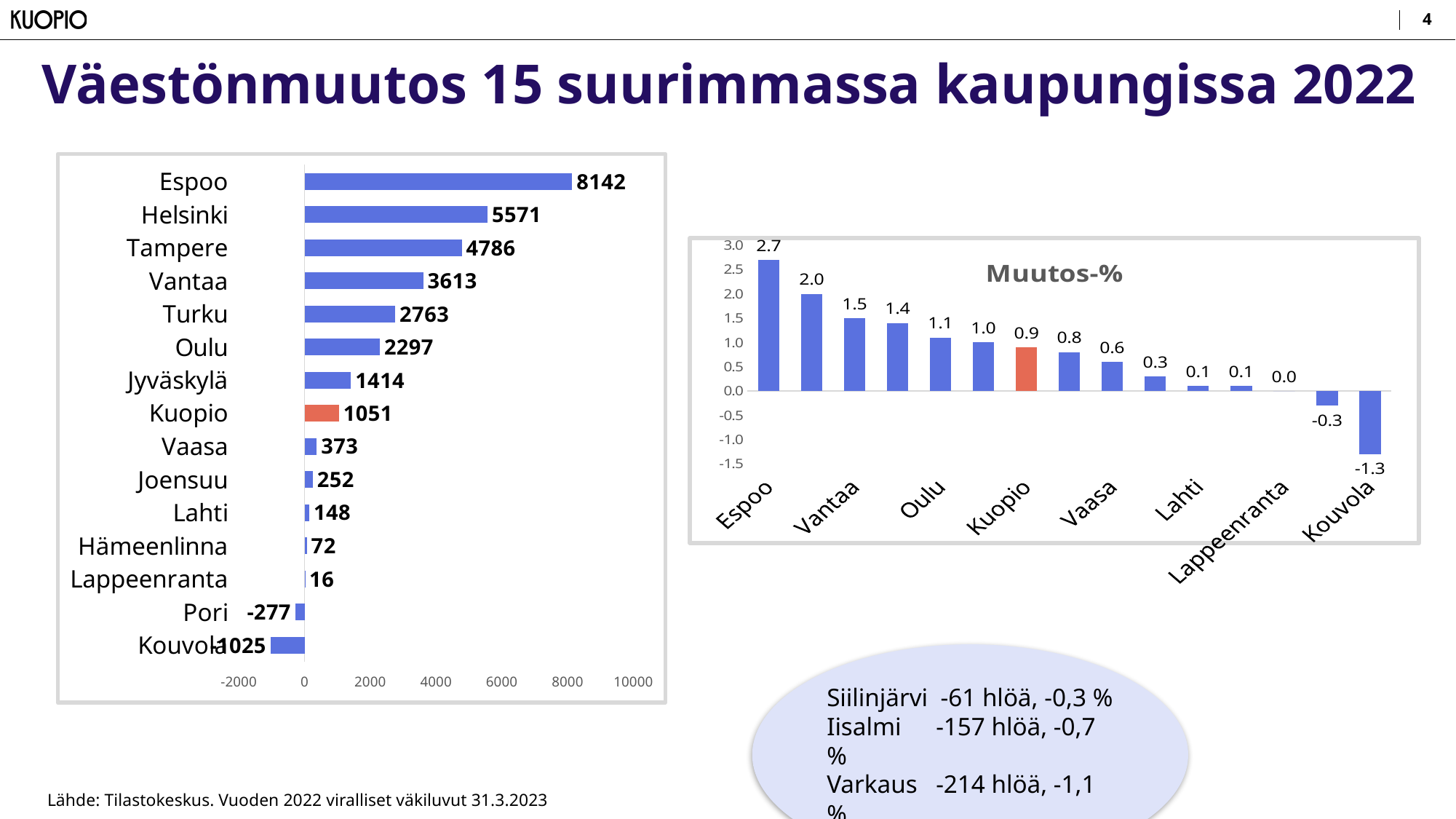
In the left bar chart, what is the value for Kuopio? 1051 In the Muutos-% chart, which city has the highest value? Espoo In the left bar chart, what is the value for Espoo? 8142 In the left bar chart, what is the difference between the values for Helsinki and Tampere? 785 In the Muutos-% chart, which bar is coloured differently (orange) from the others? Kuopio In the Muutos-% chart, what is the value for Kouvola? -1.3 How many cities are shown in the left bar chart? 15 In the Muutos-% chart, what is the difference between the values for Vantaa and Oulu? 0.4 In the left bar chart, which is larger, the value for Turku or the value for Oulu? Turku In the Muutos-% chart, what is the value for Kuopio? 0.9 In the left bar chart, which city has the lowest value? Kouvola What kind of chart is the left chart? Bar chart